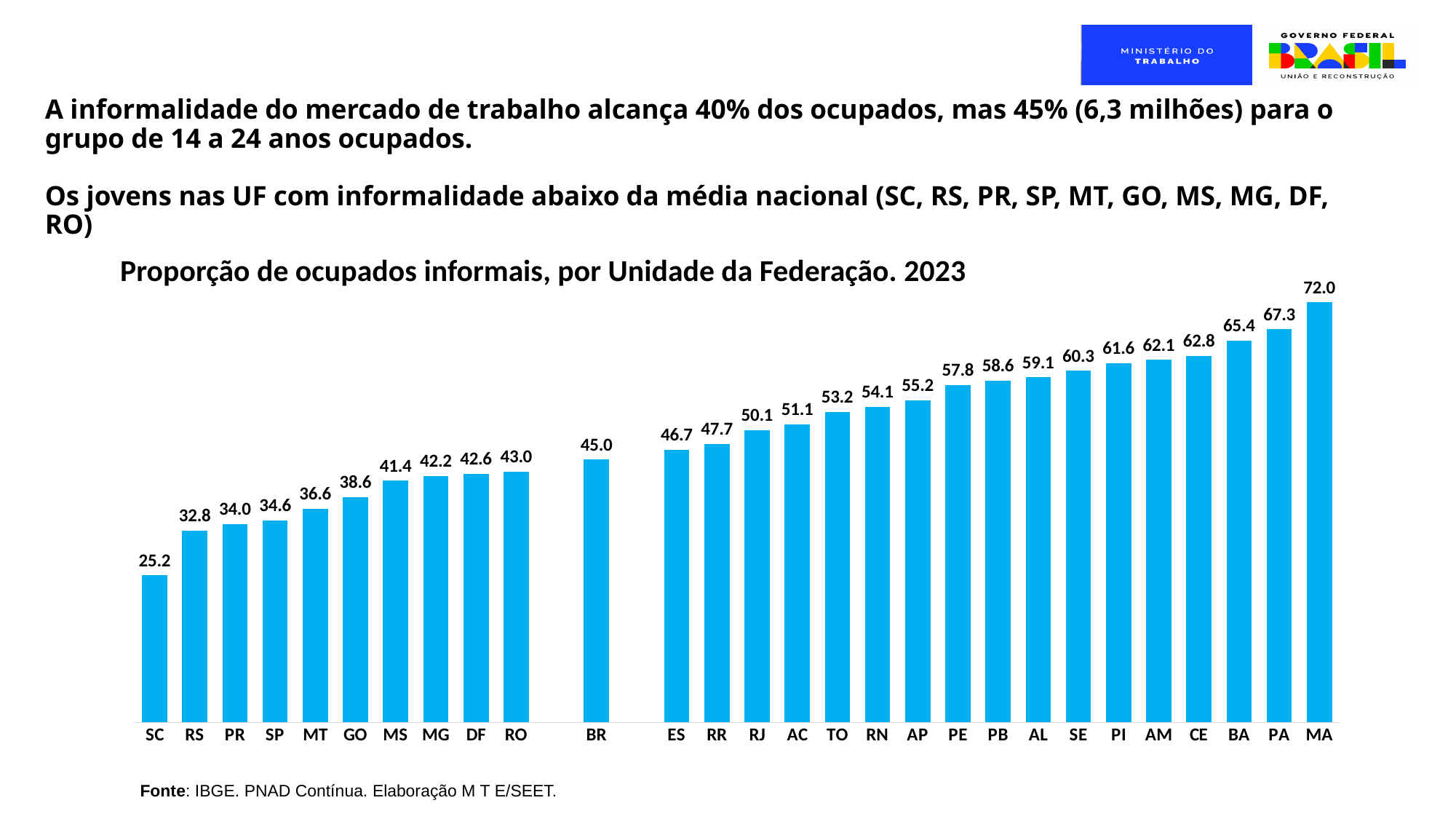
Which category has the lowest value in the chart? SC How many bars are plotted in the chart? 28 What is the difference between the values for MA and SC? 46.8 What is the value for CE in the chart? 62.8 What is the difference between the values for MA and BR? 27.0 What is the value for BR in the chart? 45.0 Do the values rise or fall from left to right along the x axis? Rise What kind of chart is shown on the slide? Bar chart Which category has the highest value in the chart? MA What is the value for RJ in the chart? 50.1 What is the value for SC in the chart 'Proporção de ocupados informais, por Unidade da Federação. 2023'? 25.2 Which has a larger value, PA or BA? PA